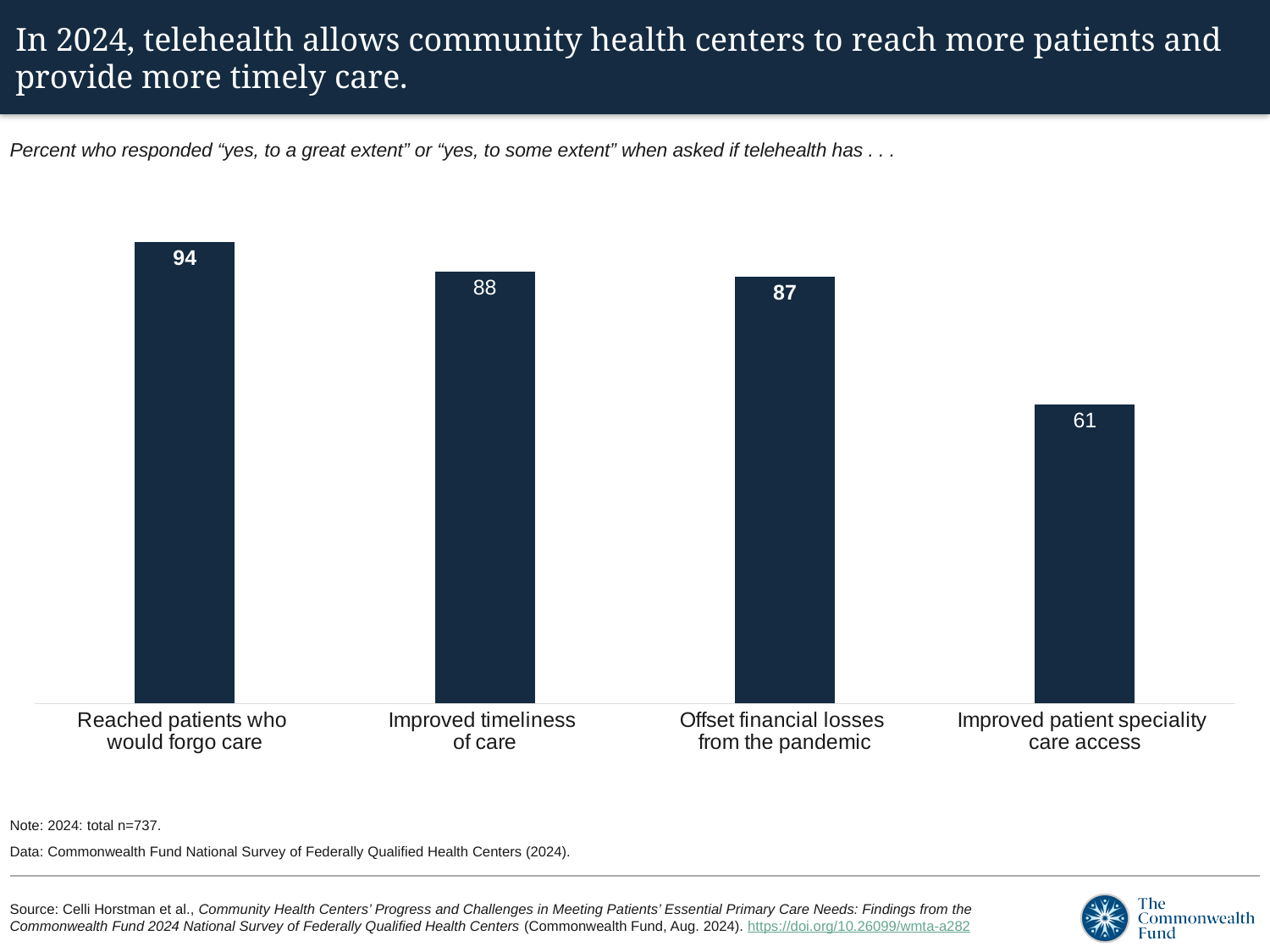
What is the value for "Reached patients who would forgo care"? 94 What is the value for "Improved patient speciality care access"? 61 What is the sample size noted for the 2024 survey? n=737 What is the difference between the values for "Improved timeliness of care" and "Offset financial losses from the pandemic"? 1 What is the difference between the values for "Reached patients who would forgo care" and "Improved patient speciality care access"? 33 How many categories are shown in the chart? 4 What is the value for "Improved timeliness of care"? 88 What is the value for "Offset financial losses from the pandemic"? 87 Which is larger: the value for "Improved timeliness of care" or the value for "Improved patient speciality care access"? Improved timeliness of care What kind of chart is shown on the slide? Bar chart Which category has the highest value? Reached patients who would forgo care Which category has the lowest value? Improved patient speciality care access